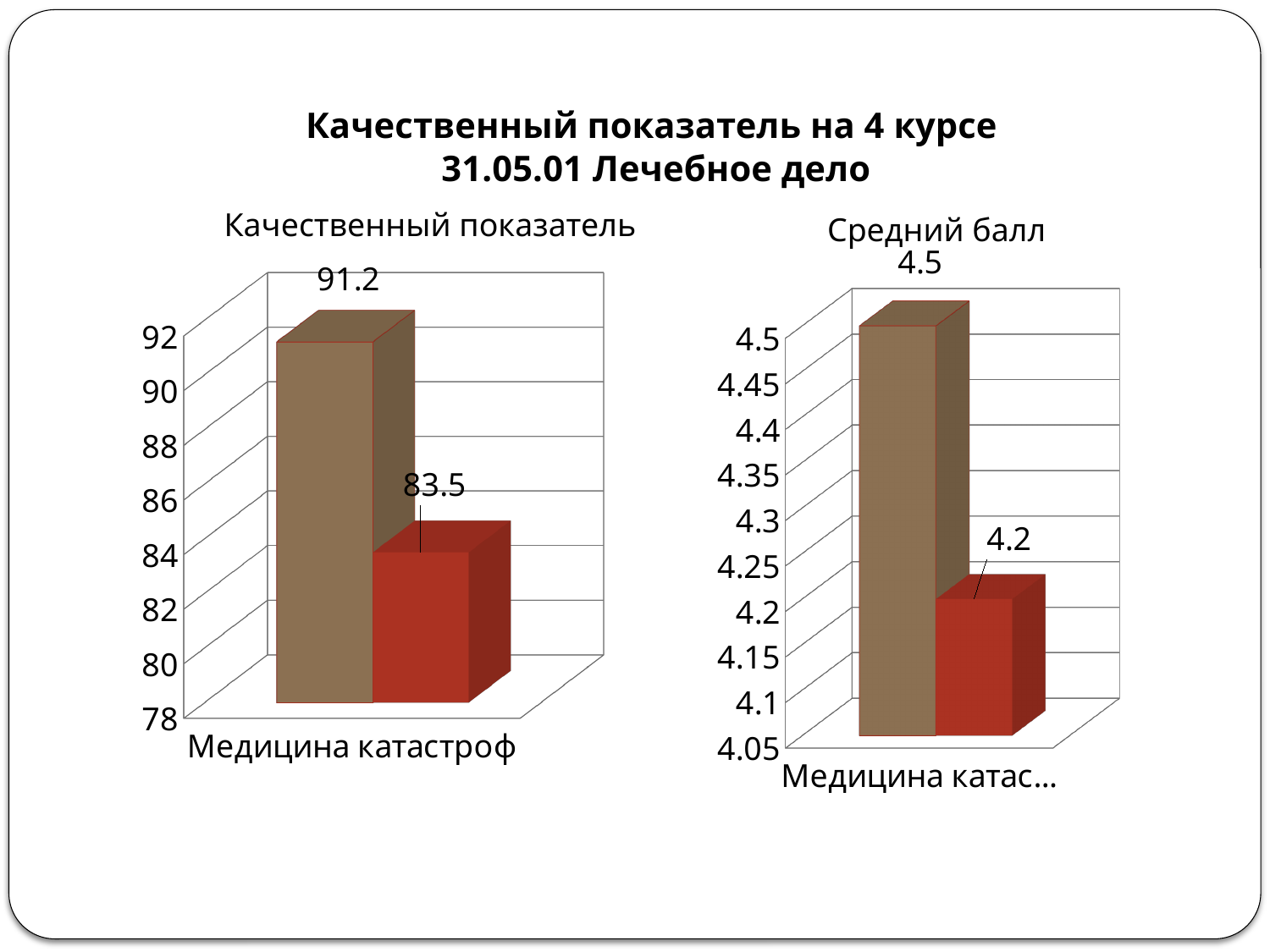
In the chart titled "Качественный показатель", is the value of the brown bar greater or less than 90? greater What is the category label on the x axis of the chart titled "Качественный показатель"? Медицина катастроф In the chart titled "Качественный показатель", what value is labelled on the brown (left) bar? 91.2 In the chart titled "Средний балл", what value is labelled on the brown (left) bar? 4.5 What kind of chart is the chart titled "Качественный показатель"? bar chart How many bars are plotted in the chart titled "Средний балл"? 2 In the chart titled "Средний балл", what value is labelled on the red (right) bar? 4.2 In the chart titled "Средний балл", what is the difference between the two labelled bar values? 0.3 In the chart titled "Средний балл", is the value of the red bar greater or less than 4.3? less In the chart titled "Качественный показатель", what is the difference between the two labelled bar values? 7.7 In the chart titled "Качественный показатель", what value is labelled on the red (right) bar? 83.5 In the chart titled "Качественный показатель", which bar is taller, the brown one or the red one? the brown one